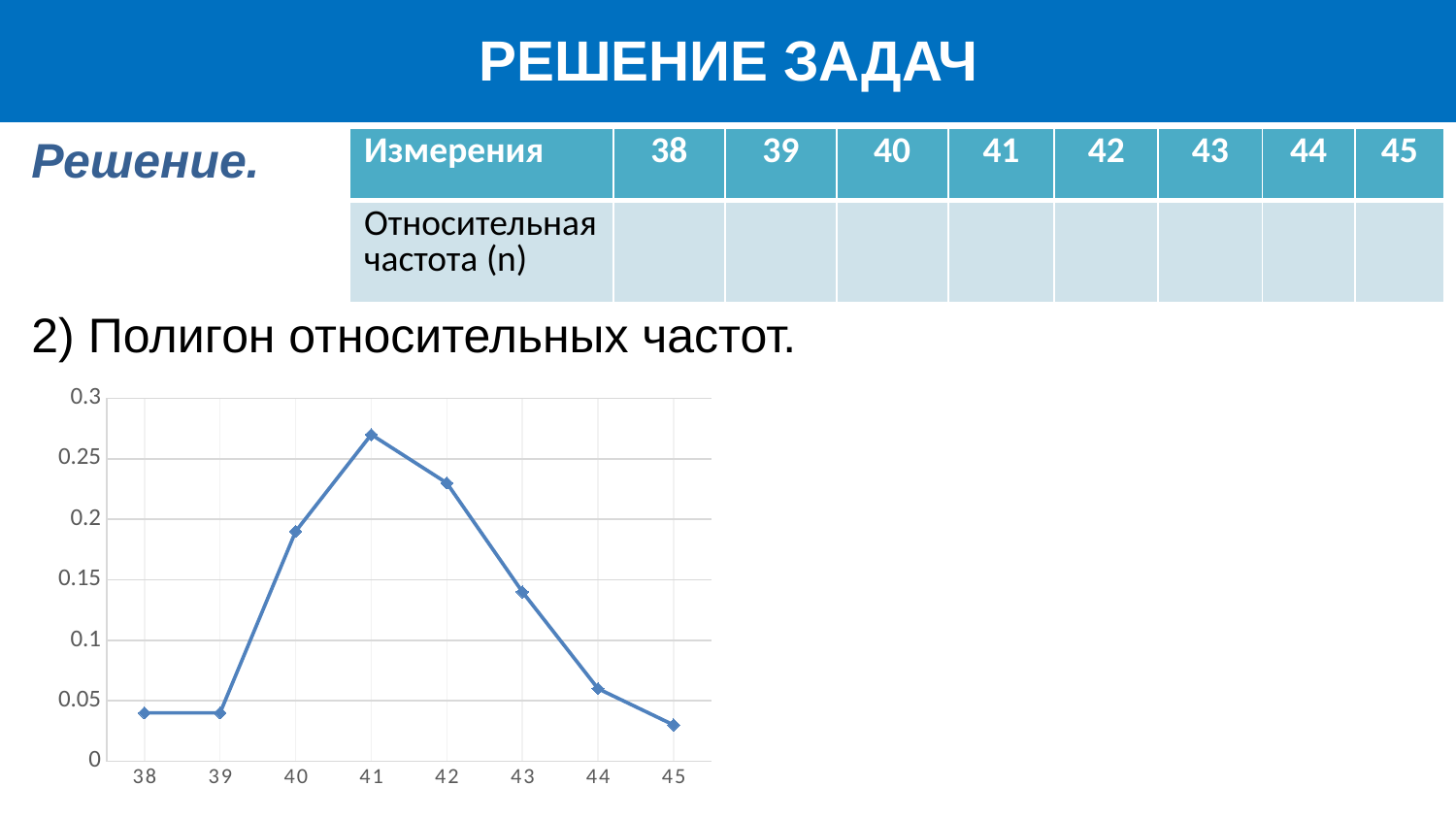
Is the value for 41 greater or less than 0.25? greater Which has the larger value, 43 or 44? 43 How many data points are plotted on the chart? 8 Is the value for 45 greater or less than 0.05? less Which has the larger value, 40 or 42? 42 Is the value for 43 greater or less than 0.1? greater Do the values rise or fall along the x axis from 41 to 45? fall Which x-axis value has the highest relative frequency on the chart? 41 What kind of chart is shown on the slide? line chart